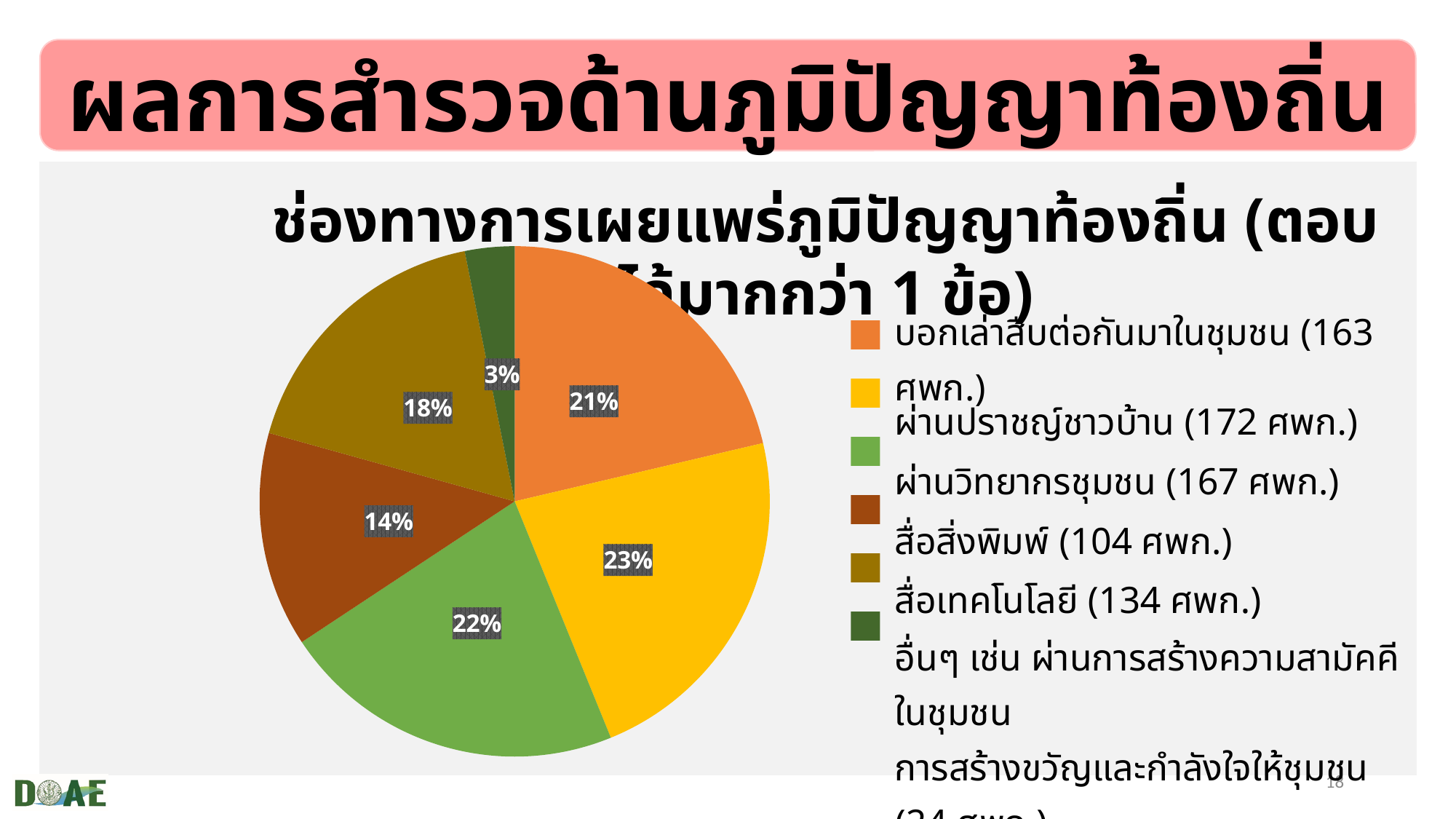
What is the difference in percentage points between the ผ่านวิทยากรชุมชน slice and the สื่อสิ่งพิมพ์ slice? 8 How many slices does the pie chart have? 6 Which slice is larger, สื่อเทคโนโลยี or สื่อสิ่งพิมพ์? สื่อเทคโนโลยี What percentage share does the slice for ผ่านปราชญ์ชาวบ้าน have? 23% What percentage share does the slice for บอกเล่าสืบต่อกันมาในชุมชน have? 21% What percentage share does the slice for สื่อสิ่งพิมพ์ have? 14% What colour is the slice for สื่อสิ่งพิมพ์? brown Which category has the largest share of the pie? ผ่านปราชญ์ชาวบ้าน Which category has the smallest share of the pie? อื่นๆ How many ศพก. are listed in the legend for ผ่านวิทยากรชุมชน? 167 ศพก. What kind of chart is shown on the slide? pie chart